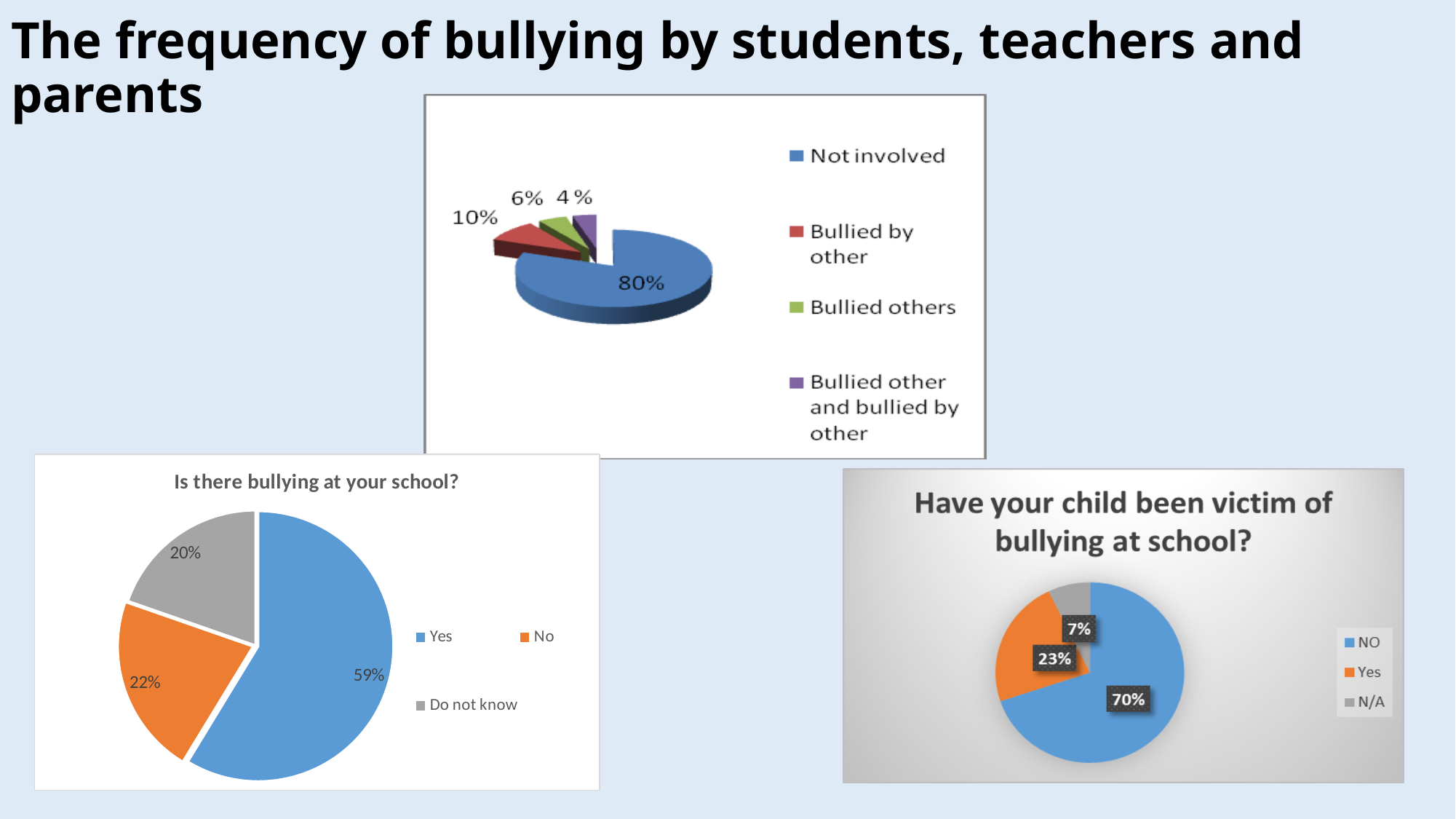
In the top pie chart, what is the difference between the 'Bullied by other' share and the 'Bullied others' share? 4% In the chart titled 'Have your child been victim of bullying at school?', which category has the largest share? NO In the top pie chart, which category has the smallest share? Bullied other and bullied by other In the chart titled 'Have your child been victim of bullying at school?', what is the difference between the 'NO' share and the 'Yes' share? 47% In the top pie chart, how many categories does the legend list? 4 What type of chart is the chart titled 'Is there bullying at your school?'? Pie chart In the chart titled 'Is there bullying at your school?', what share answered 'Do not know'? 20% In the top pie chart, what share of students were 'Bullied by other'? 10% In the chart titled 'Have your child been victim of bullying at school?', what share answered 'Yes'? 23% In the chart titled 'Is there bullying at your school?', what share answered 'Yes'? 59% In the chart titled 'Is there bullying at your school?', which is larger, 'No' or 'Do not know'? No In the top pie chart, what share of students are 'Not involved'? 80%